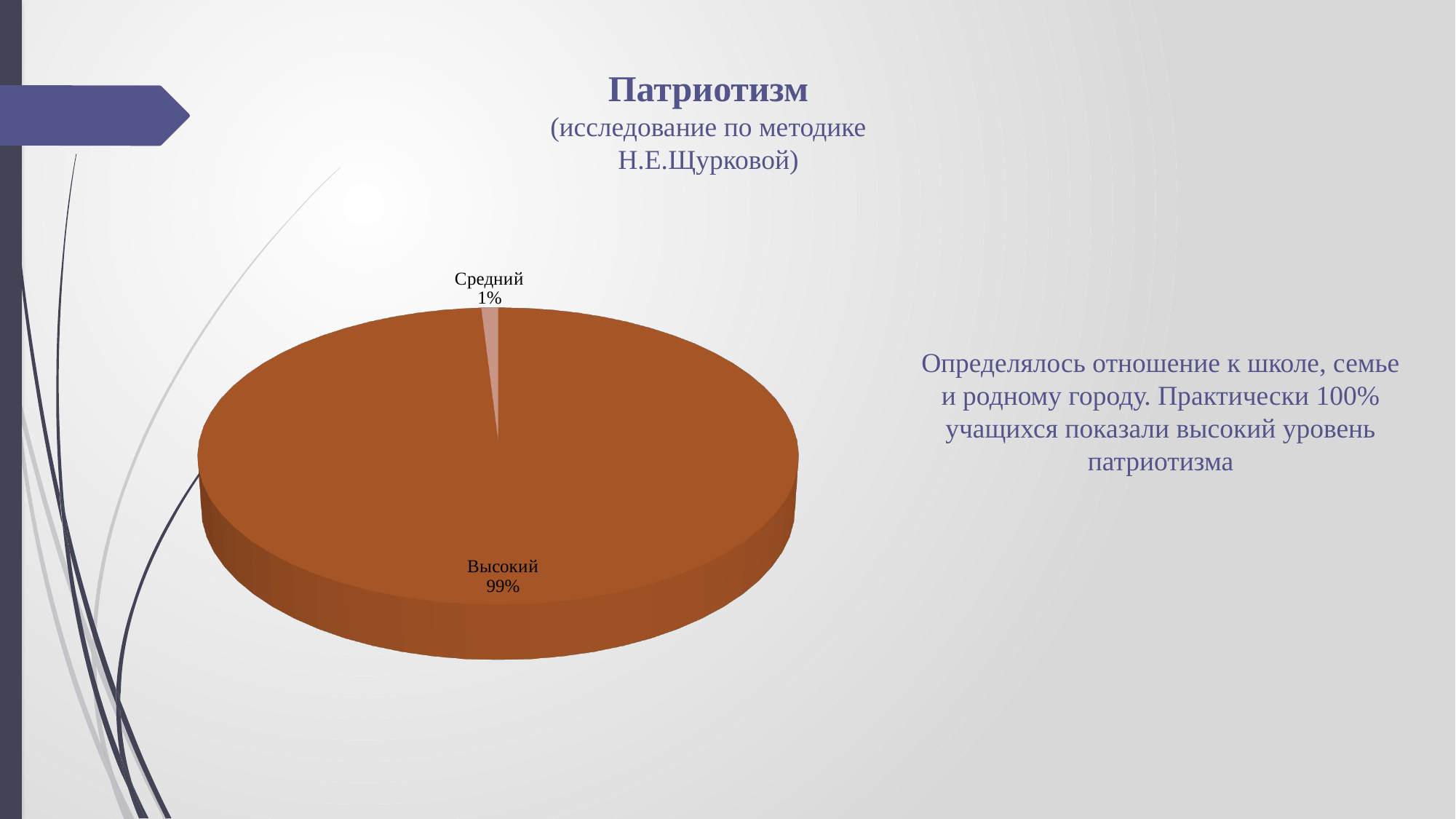
Which slice is larger, "Высокий" or "Средний"? Высокий Which category has the smallest slice of the pie? Средний What kind of chart is shown on the slide? pie chart Which category has the largest slice of the pie? Высокий What is the difference in percentage points between the "Высокий" and "Средний" slices? 98 What share of the pie does the "Высокий" slice represent? 99% What colour is the "Высокий" slice of the pie? brown What is the total of the two slices shown in the pie chart? 100% How many slices does the pie chart have? 2 What is the title of the chart on the slide? Патриотизм What share of the pie does the "Средний" slice represent? 1%